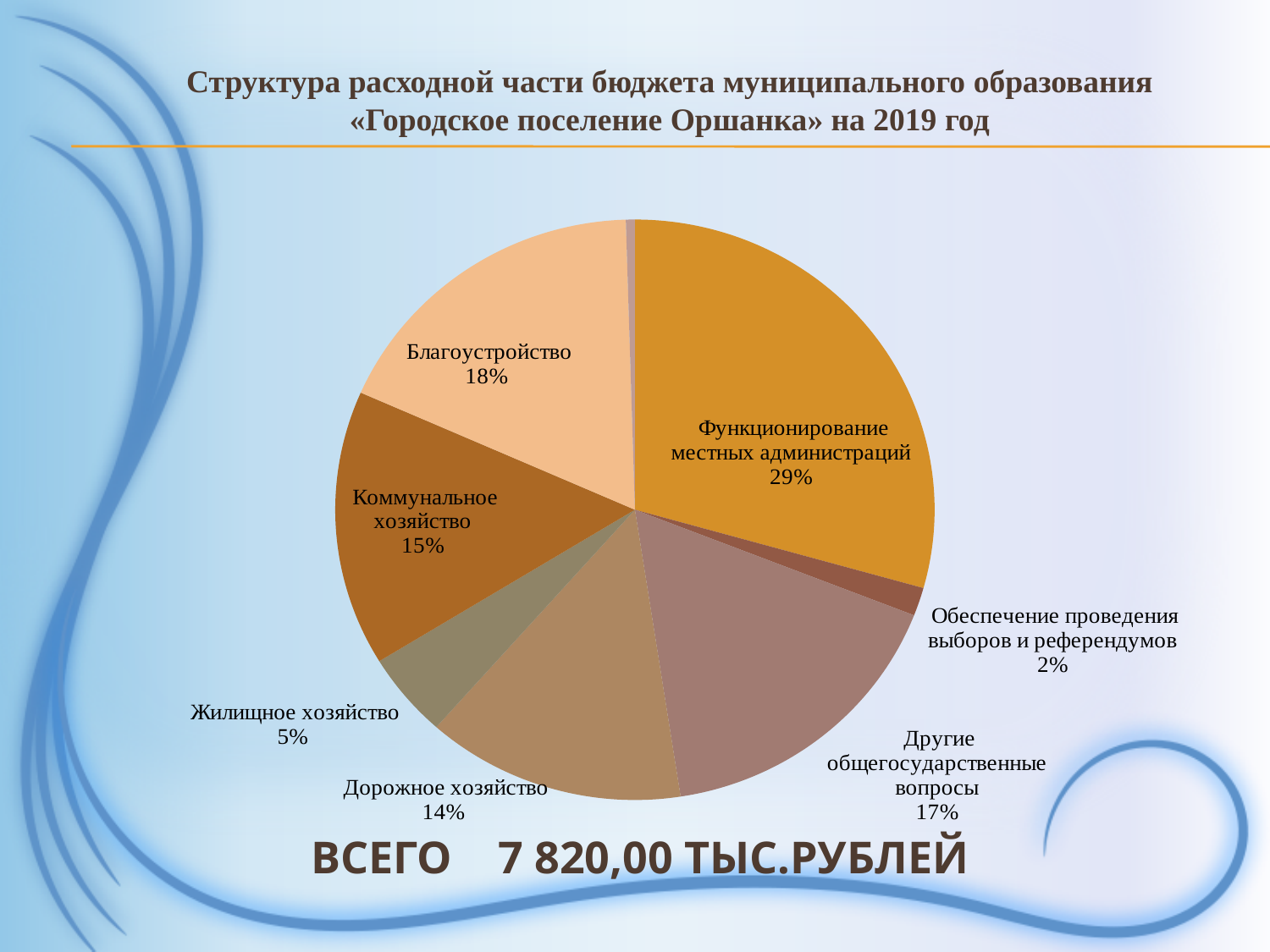
What is the difference in percentage points between Функционирование местных администраций and Другие общегосударственные вопросы? 12 What share of the budget expenditure goes to Функционирование местных администраций? 29% What is the difference in percentage points between Благоустройство and Коммунальное хозяйство? 3 What share of the budget expenditure goes to Дорожное хозяйство? 14% Which labeled category has the smallest share of the pie? Обеспечение проведения выборов и референдумов What kind of chart is shown on the slide? pie chart What year does the chart title say the budget structure refers to? 2019 What share of the budget expenditure goes to Обеспечение проведения выборов и референдумов? 2% Which labeled category has the largest share of the pie? Функционирование местных администраций What total amount is stated below the chart? 7 820,00 тыс.рублей Which is larger: the share for Коммунальное хозяйство or the share for Жилищное хозяйство? Коммунальное хозяйство